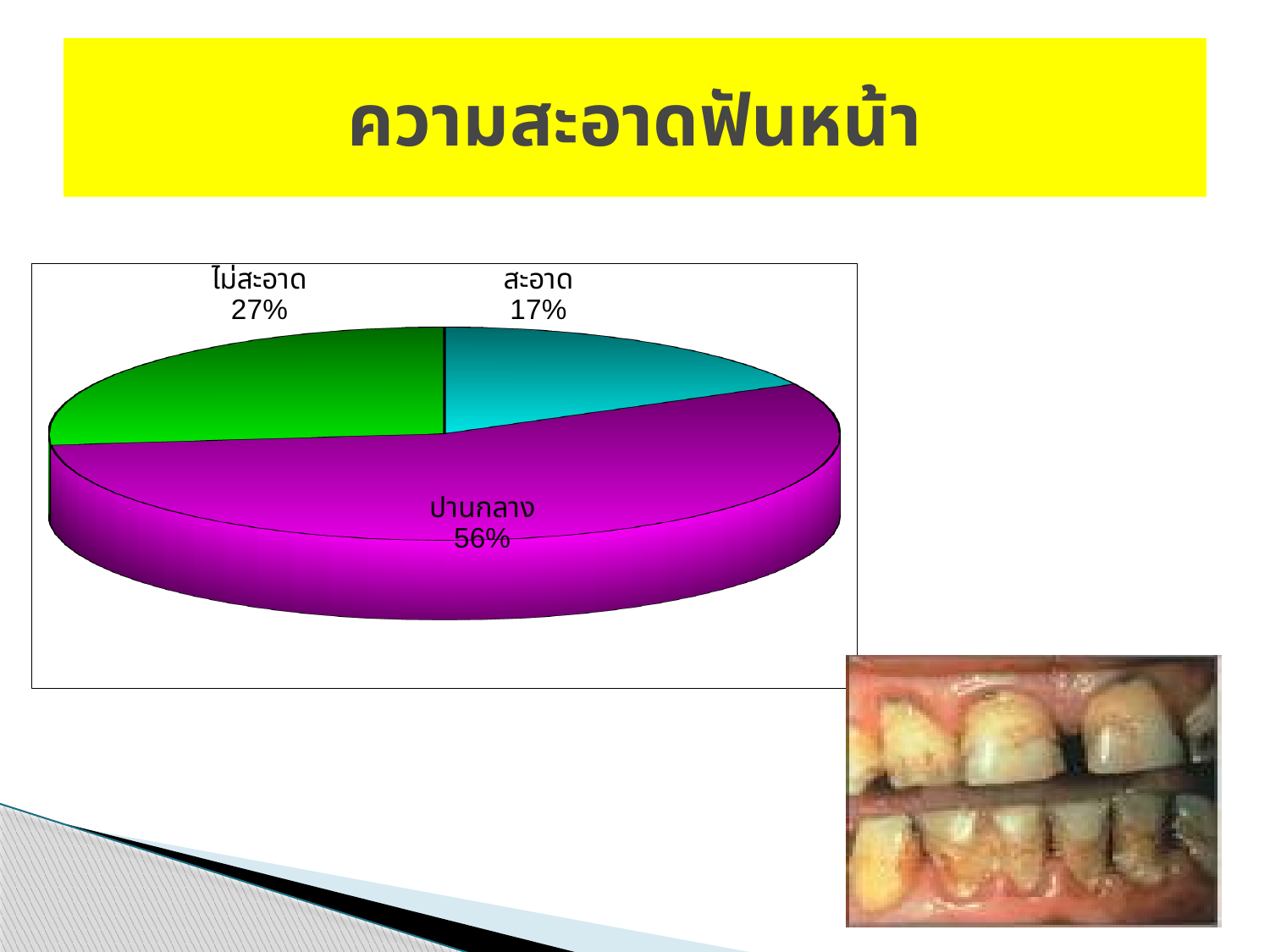
What is the value for สะอาด? 17% Which category has the smallest share of the pie? สะอาด Which is larger, the value for ไม่สะอาด or the value for สะอาด? ไม่สะอาด What is the difference between the values for ปานกลาง and ไม่สะอาด? 29% What is the value for ไม่สะอาด? 27% What is the difference between the values for ไม่สะอาด and สะอาด? 10% Which category has the largest share of the pie? ปานกลาง What colour is the ปานกลาง slice? Purple How many slices does the pie chart have? 3 What kind of chart is shown on the slide? Pie chart What is the title of the slide containing the chart? ความสะอาดฟันหน้า What is the value for ปานกลาง? 56%